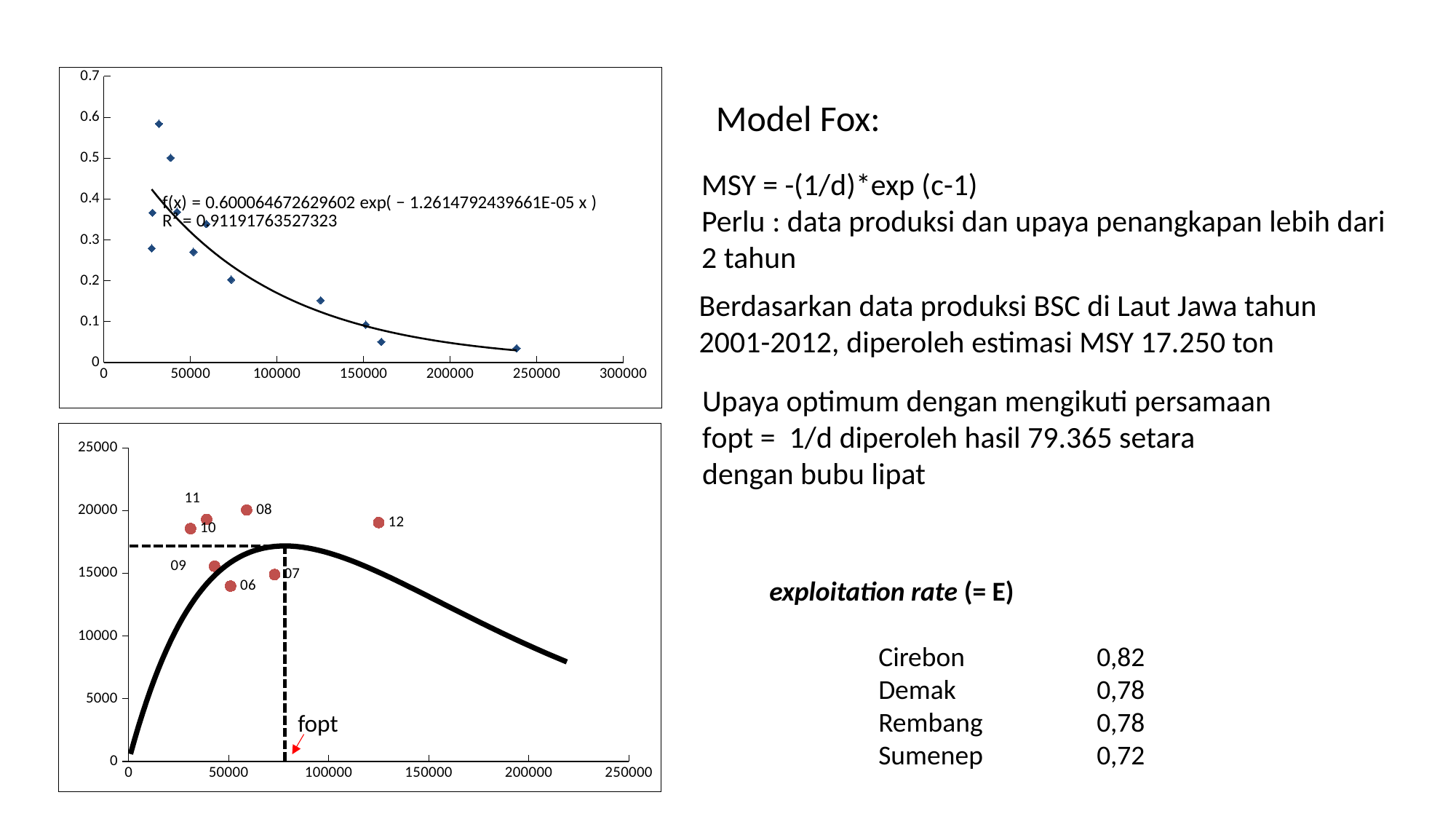
In the bottom chart, how many labelled data points are plotted? 7 In the bottom chart, is the dashed vertical line labelled fopt located at an x value greater or less than 100000? less In the top chart, what R² value is printed for the fitted curve? 0.91191763527323 In the bottom chart, is the value for point 12 greater or less than 20000? less In the top chart, is the value of the rightmost point (near x = 250000) greater or less than 0.1? less In the bottom chart, which labelled point has the lowest value? 06 What kind of chart is the bottom chart on the slide? scatter chart In the bottom chart, which has the larger value, point 08 or point 09? 08 In the top chart, do the plotted values rise or fall as the x-axis value increases? fall What kind of chart is the top chart on the slide? scatter chart